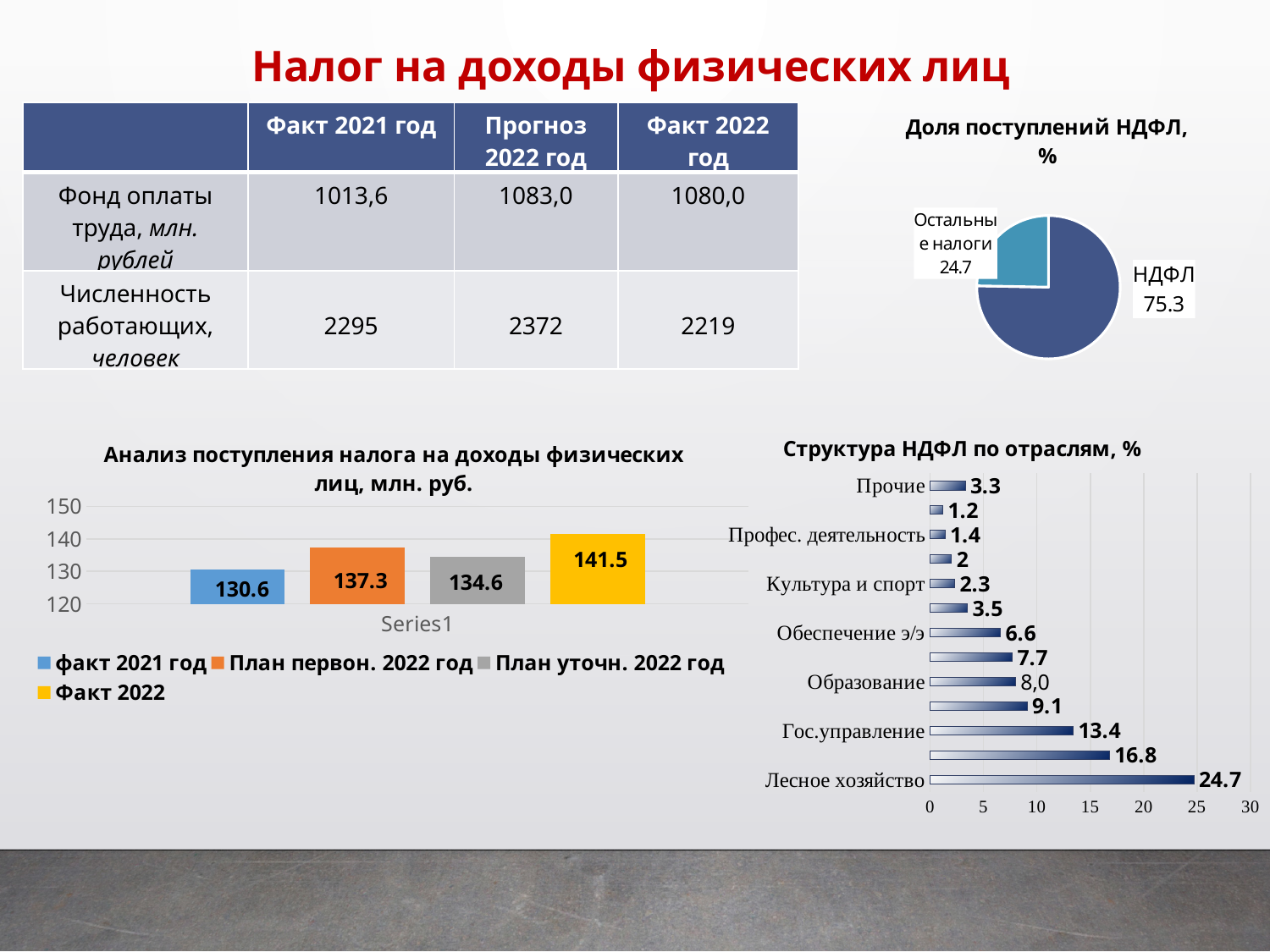
In the pie chart 'Доля поступлений НДФЛ, %', what share does НДФЛ have? 75.3 In the chart 'Анализ поступления налога на доходы физических лиц, млн. руб.', which series has the lowest value? факт 2021 год In the chart 'Анализ поступления налога на доходы физических лиц, млн. руб.', which series has the highest value? Факт 2022 In the chart 'Анализ поступления налога на доходы физических лиц, млн. руб.', how many series does the legend list? 4 In the chart 'Структура НДФЛ по отраслям, %', which is larger: Образование or Обеспечение э/э? Образование In the chart 'Структура НДФЛ по отраслям, %', how many bars are plotted? 13 In the chart 'Структура НДФЛ по отраслям, %', what is the value for Лесное хозяйство? 24.7 In the chart 'Структура НДФЛ по отраслям, %', what is the difference between Лесное хозяйство and Гос.управление? 11.3 In the chart 'Анализ поступления налога на доходы физических лиц, млн. руб.', what is the difference between Факт 2022 and факт 2021 год? 10.9 In the chart 'Анализ поступления налога на доходы физических лиц, млн. руб.', what is the value for Факт 2022? 141.5 What kind of chart is 'Анализ поступления налога на доходы физических лиц, млн. руб.'? bar chart In the pie chart 'Доля поступлений НДФЛ, %', how many slices are there? 2